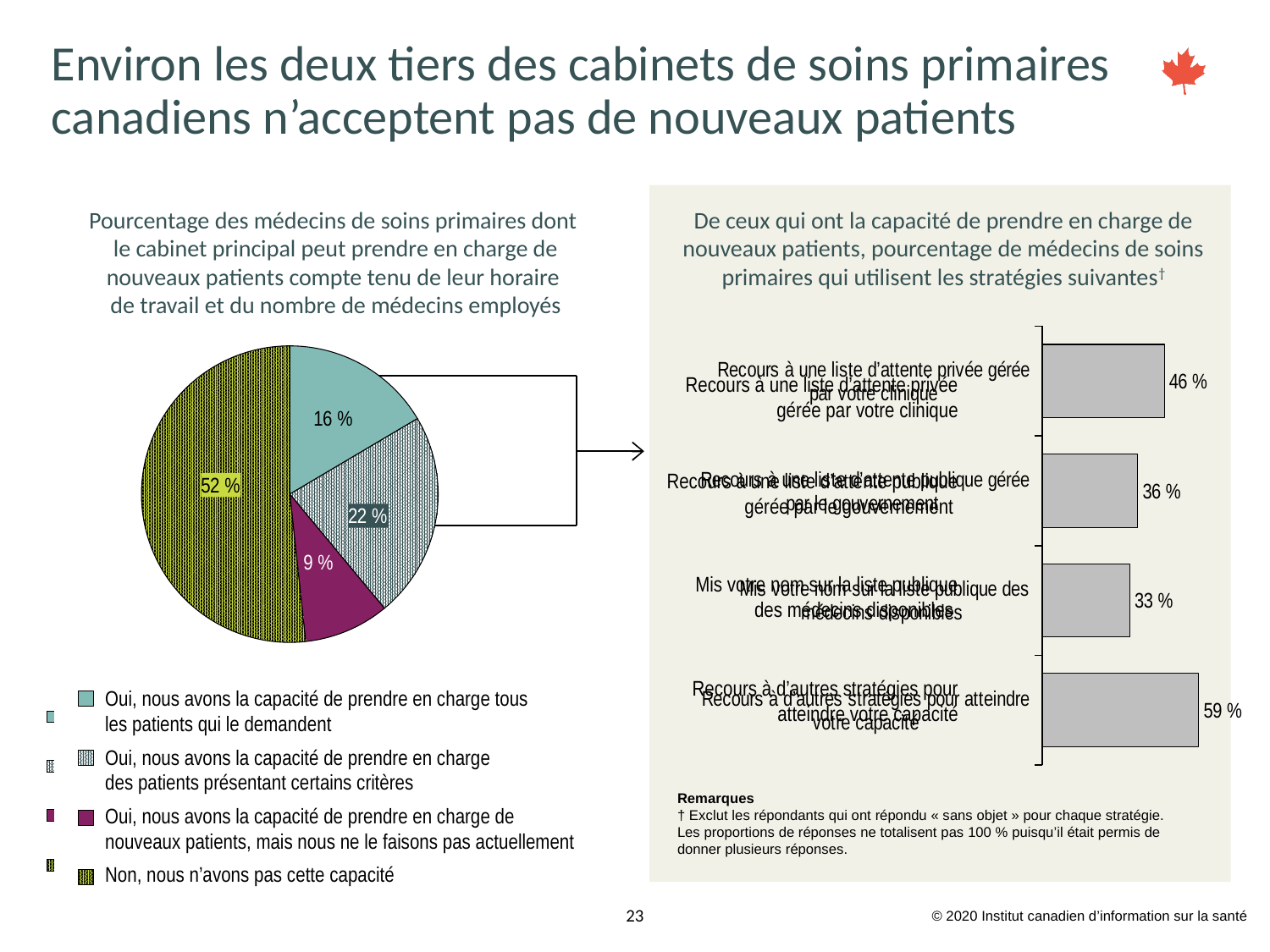
In the bar chart on the right, which is larger: the value for "Recours à une liste d'attente publique gérée par le gouvernement" or the value for "Mis votre nom sur la liste publique des médecins disponibles"? Recours à une liste d'attente publique gérée par le gouvernement In the bar chart on the right, what percentage of physicians use "Mis votre nom sur la liste publique des médecins disponibles"? 33 % In the bar chart on the right, what percentage of physicians use "Recours à une liste d'attente privée gérée par votre clinique"? 46 % In the pie chart on the left, how many slices are there? 4 In the pie chart on the left, which response category has the smallest share? Oui, nous avons la capacité de prendre en charge de nouveaux patients, mais nous ne le faisons pas actuellement In the bar chart on the right, how many strategies are plotted? 4 In the bar chart on the right, what is the difference between the value for "Recours à d'autres stratégies pour atteindre votre capacité" and the value for "Recours à une liste d'attente privée gérée par votre clinique"? 13 % In the pie chart on the left, what is the difference between the share for "Oui, nous avons la capacité de prendre en charge des patients présentant certains critères" and the share for "Oui, nous avons la capacité de prendre en charge tous les patients qui le demandent"? 6 % What type of chart is shown on the right side of the slide? Bar chart In the bar chart on the right, which strategy has the highest percentage? Recours à d'autres stratégies pour atteindre votre capacité In the pie chart on the left, what percentage corresponds to "Oui, nous avons la capacité de prendre en charge tous les patients qui le demandent"? 16 % In the pie chart on the left, what percentage of primary care physicians answered "Non, nous n'avons pas cette capacité"? 52 %